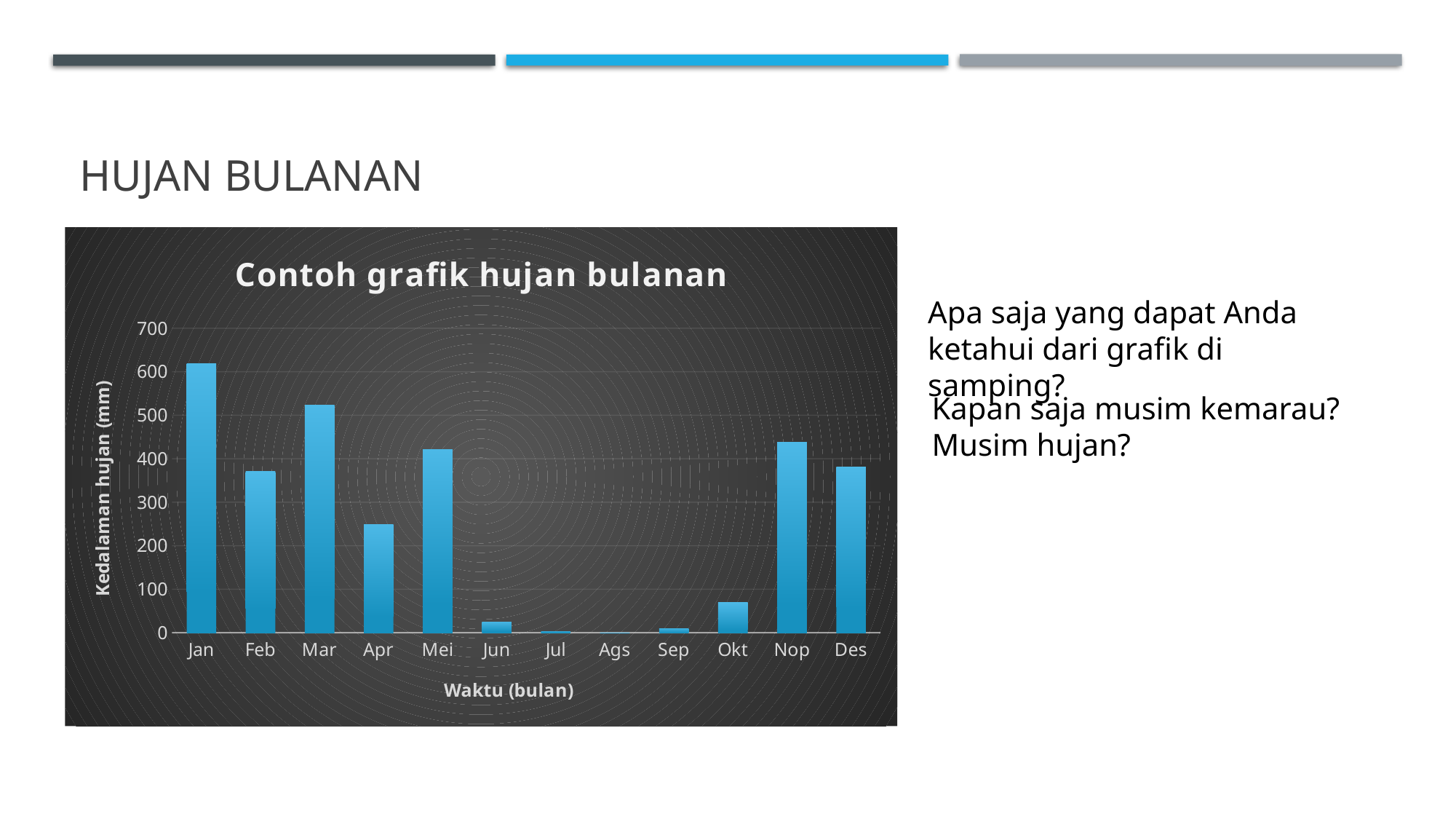
Which is larger, the value for Feb or the value for Apr? Feb Which month has the highest rainfall in the chart? Jan Is the value for Okt greater or less than 100? less What is the label of the vertical axis of the chart? Kedalaman hujan (mm) Is the value for Apr greater or less than 300? less How many months are shown on the x axis of the chart? 12 Is the value for Nop greater or less than 400? greater What kind of chart is shown on the slide? bar chart What is the title of the chart? Contoh grafik hujan bulanan Which is larger, the value for Jan or the value for Mar? Jan